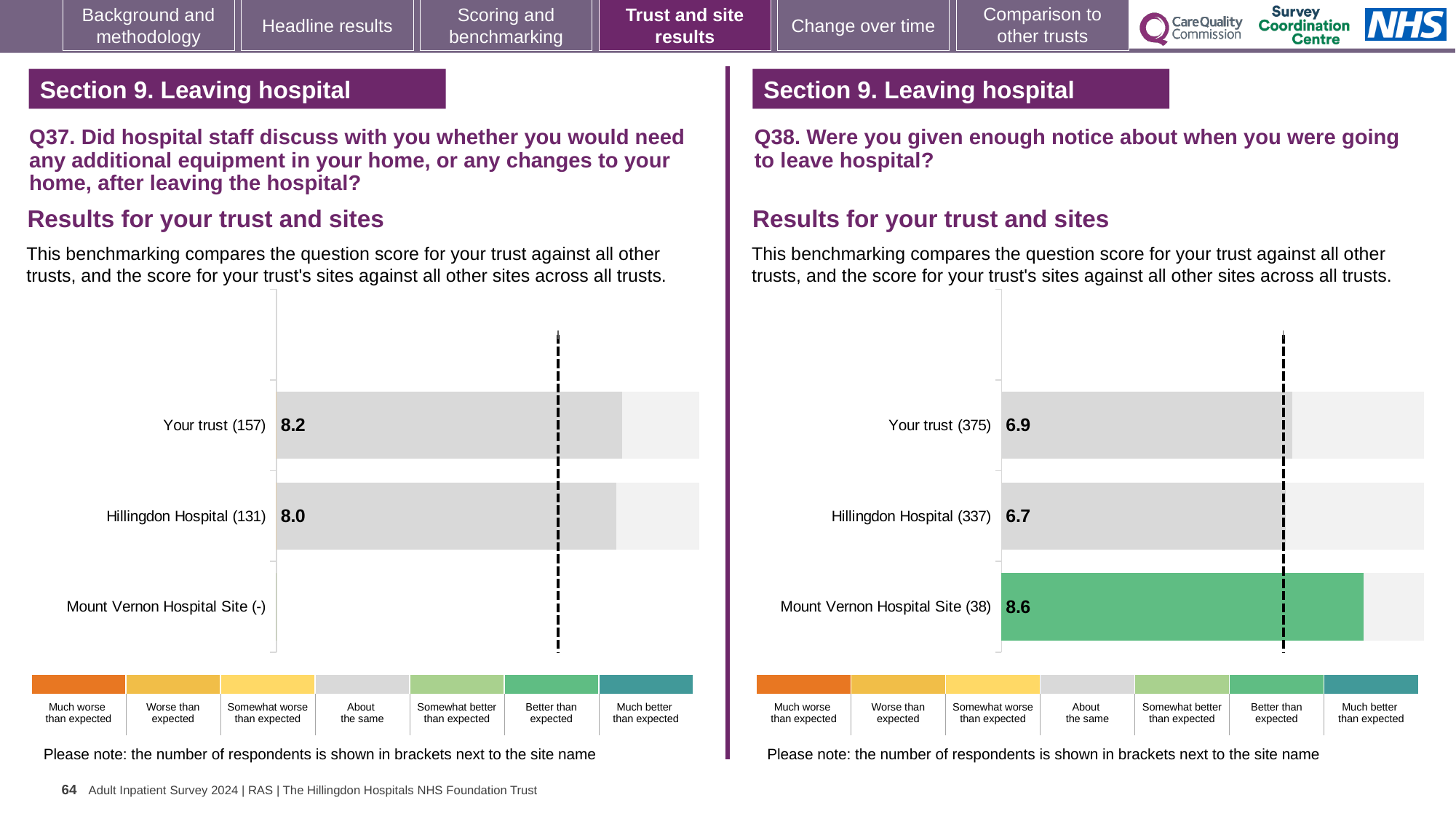
On the Q38 chart (right), what is the score for Your trust? 6.9 On the Q38 chart (right), what is the score for Mount Vernon Hospital Site? 8.6 On the Q38 chart (right), what is the score for Hillingdon Hospital? 6.7 What type of chart is used on the Q38 chart (right)? Bar chart On the Q38 chart (right), which has the larger score, Your trust or Hillingdon Hospital? Your trust On the Q38 chart (right), which site or trust has the highest score? Mount Vernon Hospital Site On the Q37 chart (left), what is the score for Your trust? 8.2 On the Q37 chart (left), how many respondents are shown in brackets for Your trust? 157 On the Q37 chart (left), what is the difference between the scores for Your trust and Hillingdon Hospital? 0.2 On the Q37 chart (left), what is the score for Hillingdon Hospital? 8.0 On the Q38 chart (right), what is the difference between the scores for Mount Vernon Hospital Site and Your trust? 1.7 On the Q38 chart (right), which site or trust has the lowest score? Hillingdon Hospital